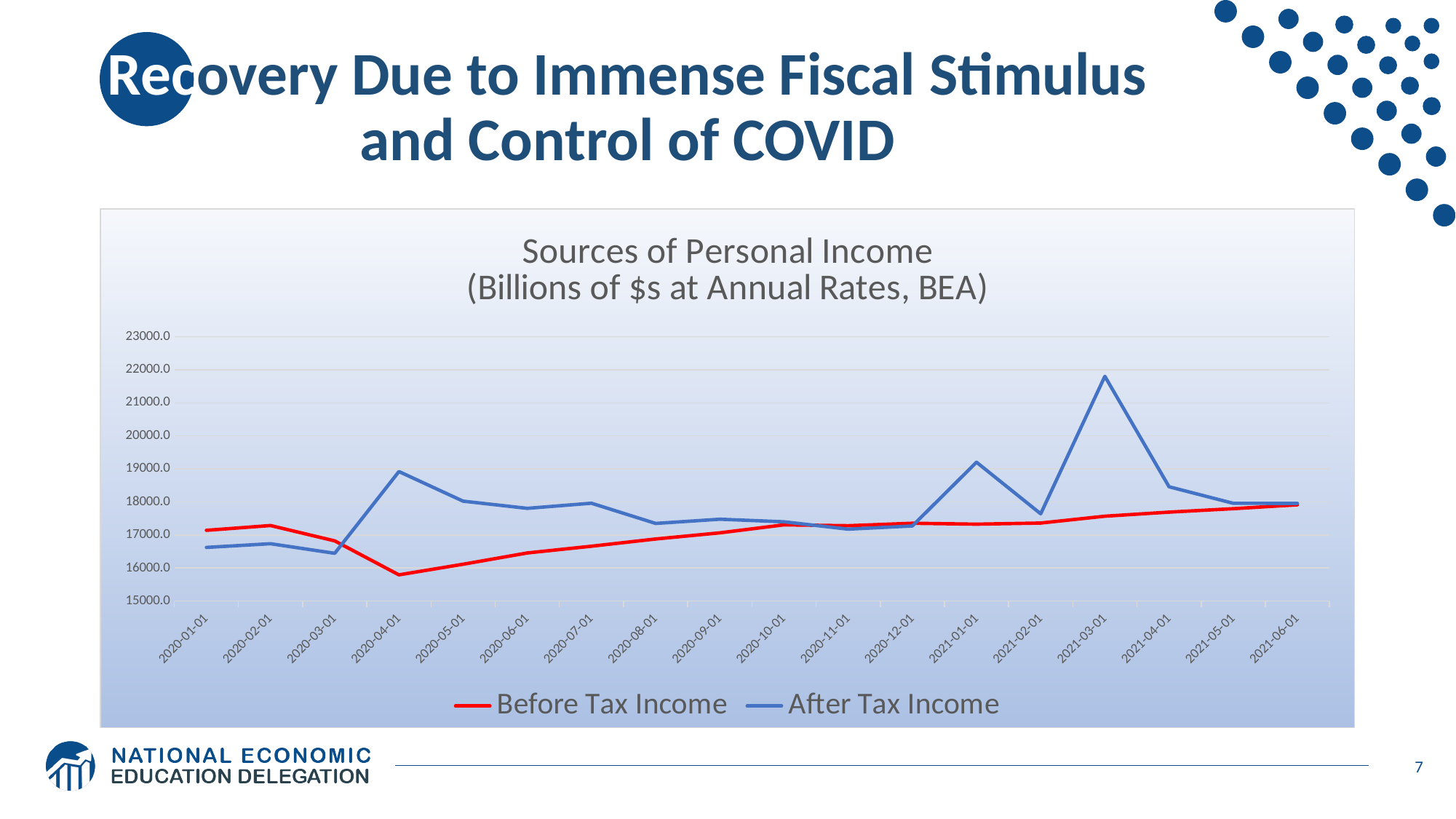
On which date does After Tax Income reach its highest value? 2021-03-01 Does Before Tax Income rise or fall from 2020-04-01 to 2021-06-01? Rise How many series does the legend list? 2 Is the value for After Tax Income on 2021-03-01 greater or less than 21000.0? greater How many dates are shown on the x axis of the chart? 18 Is the value for Before Tax Income on 2020-04-01 greater or less than 17000.0? less Is the value for After Tax Income on 2020-04-01 greater or less than 18000.0? greater What kind of chart is shown on the slide? Line chart What colour is the line for After Tax Income? Blue On 2021-01-01, which series has the larger value, Before Tax Income or After Tax Income? After Tax Income On 2020-02-01, which series has the larger value, Before Tax Income or After Tax Income? Before Tax Income On which date does Before Tax Income reach its lowest value? 2020-04-01